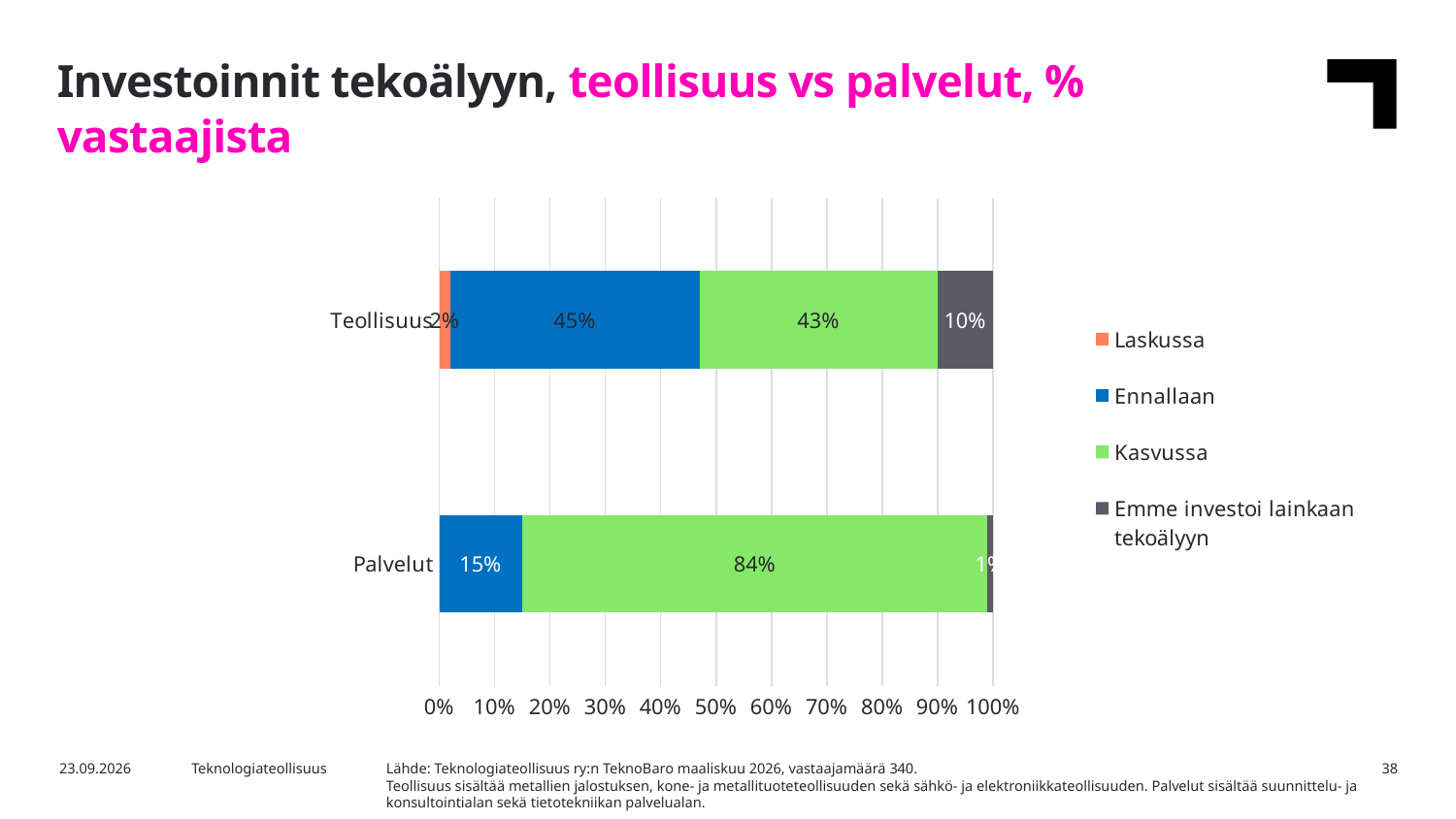
What is the Ennallaan value for Palvelut? 15% Which category has the larger Kasvussa value, Teollisuus or Palvelut? Palvelut How many series does the legend list? 4 How many categories are plotted on the chart? 2 What is the Emme investoi lainkaan tekoälyyn value for Teollisuus? 10% What is the difference between the Ennallaan values for Teollisuus and Palvelut? 30% What is the difference between the Kasvussa values for Palvelut and Teollisuus? 41% Which legend entry is shown in green? Kasvussa What is the Kasvussa value for Palvelut? 84% What kind of chart is shown on the slide? Stacked bar chart What is the Laskussa value for Teollisuus? 2% What is the Ennallaan value for Teollisuus? 45%